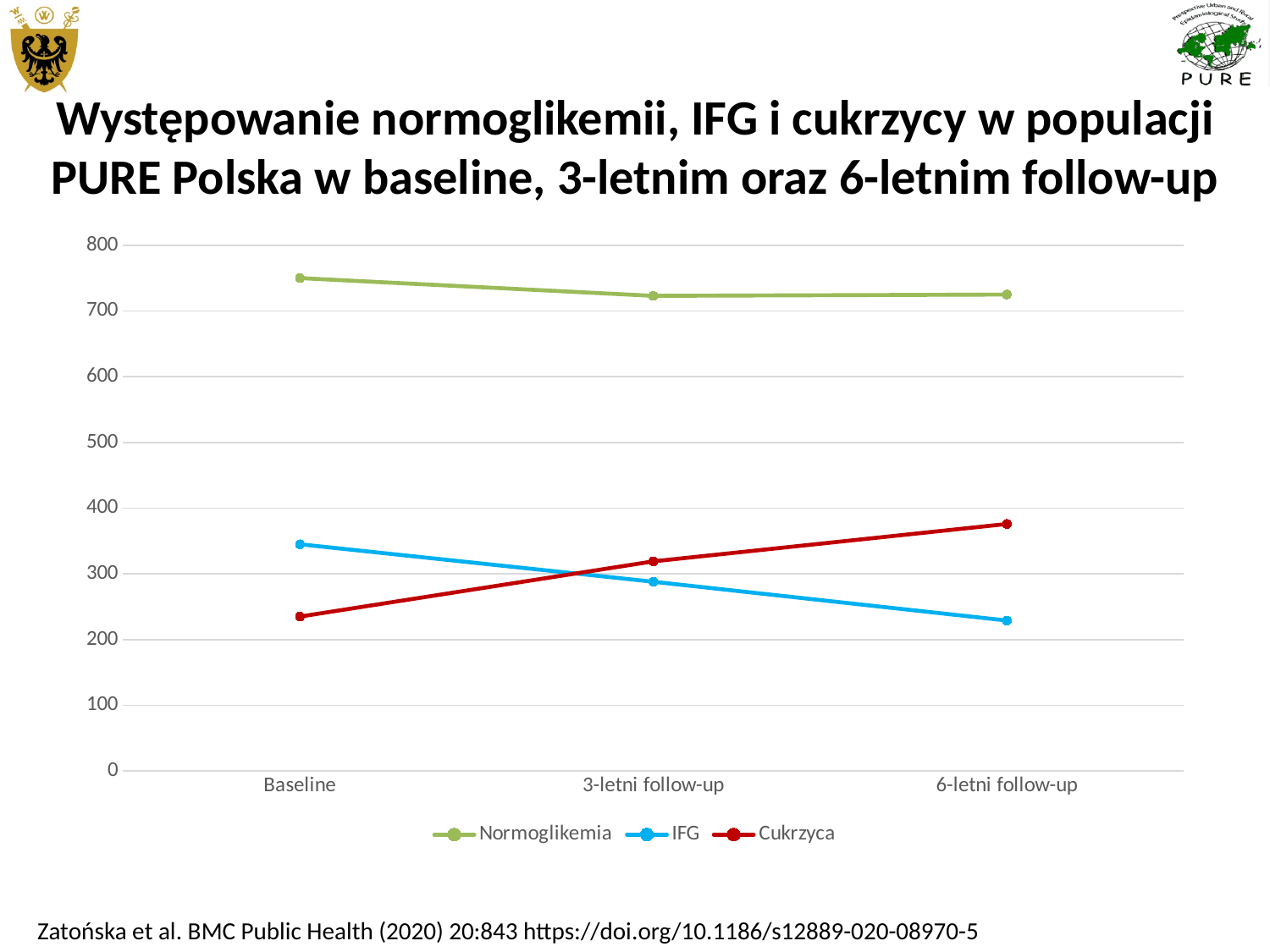
Which series has the highest values at every time point? Normoglikemia At Baseline, which is larger: IFG or Cukrzyca? IFG Does the IFG series rise or fall from Baseline to 6-letni follow-up? fall Does the Cukrzyca series rise or fall from Baseline to 6-letni follow-up? rise Is the value for Cukrzyca at Baseline greater or less than 300? less How many time points are shown on the x axis? 3 What kind of chart is shown on the slide? line chart Is the value for IFG at 6-letni follow-up greater or less than 300? less At 6-letni follow-up, which is larger: IFG or Cukrzyca? Cukrzyca Which colour is used for the IFG series? blue How many series does the legend list? 3 Is the value for Normoglikemia at Baseline greater or less than 700? greater